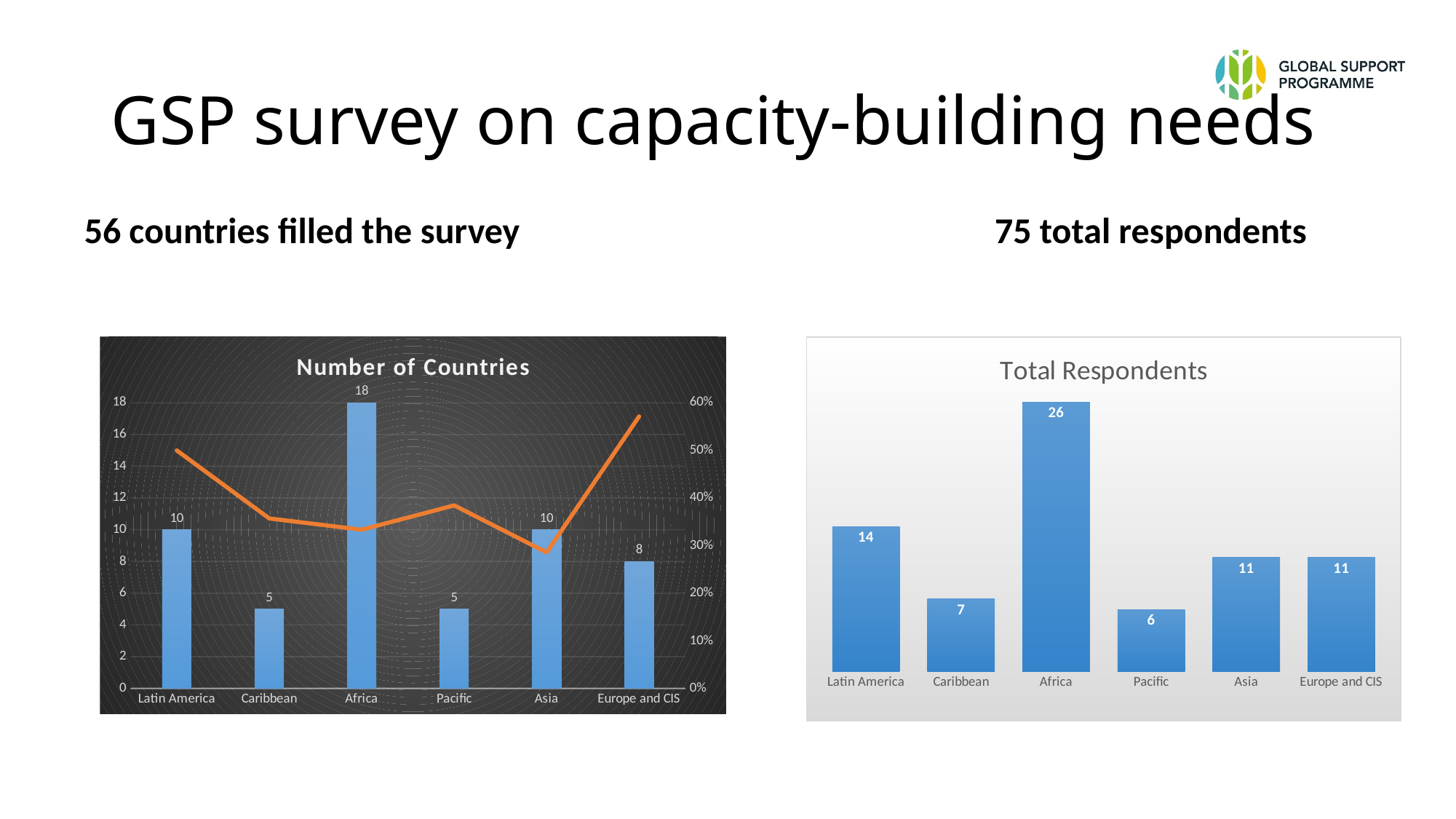
What kind of chart is the 'Total Respondents' chart? Bar chart In the 'Number of Countries' chart, is the orange line value for Europe and CIS greater or less than 50%? greater In the 'Number of Countries' chart, what is the value for Europe and CIS? 8 In the 'Number of Countries' chart, what is the value for Africa? 18 In the 'Total Respondents' chart, which is larger, the value for Caribbean or the value for Asia? Asia In the 'Total Respondents' chart, what is the difference between the values for Africa and Pacific? 20 In the 'Number of Countries' chart, what is the difference between the values for Africa and Latin America? 8 In the 'Total Respondents' chart, which category has the lowest value? Pacific How many categories are shown on the x axis of the 'Total Respondents' chart? 6 In the 'Total Respondents' chart, what is the value for Latin America? 14 In the 'Number of Countries' chart, which category has the highest bar? Africa